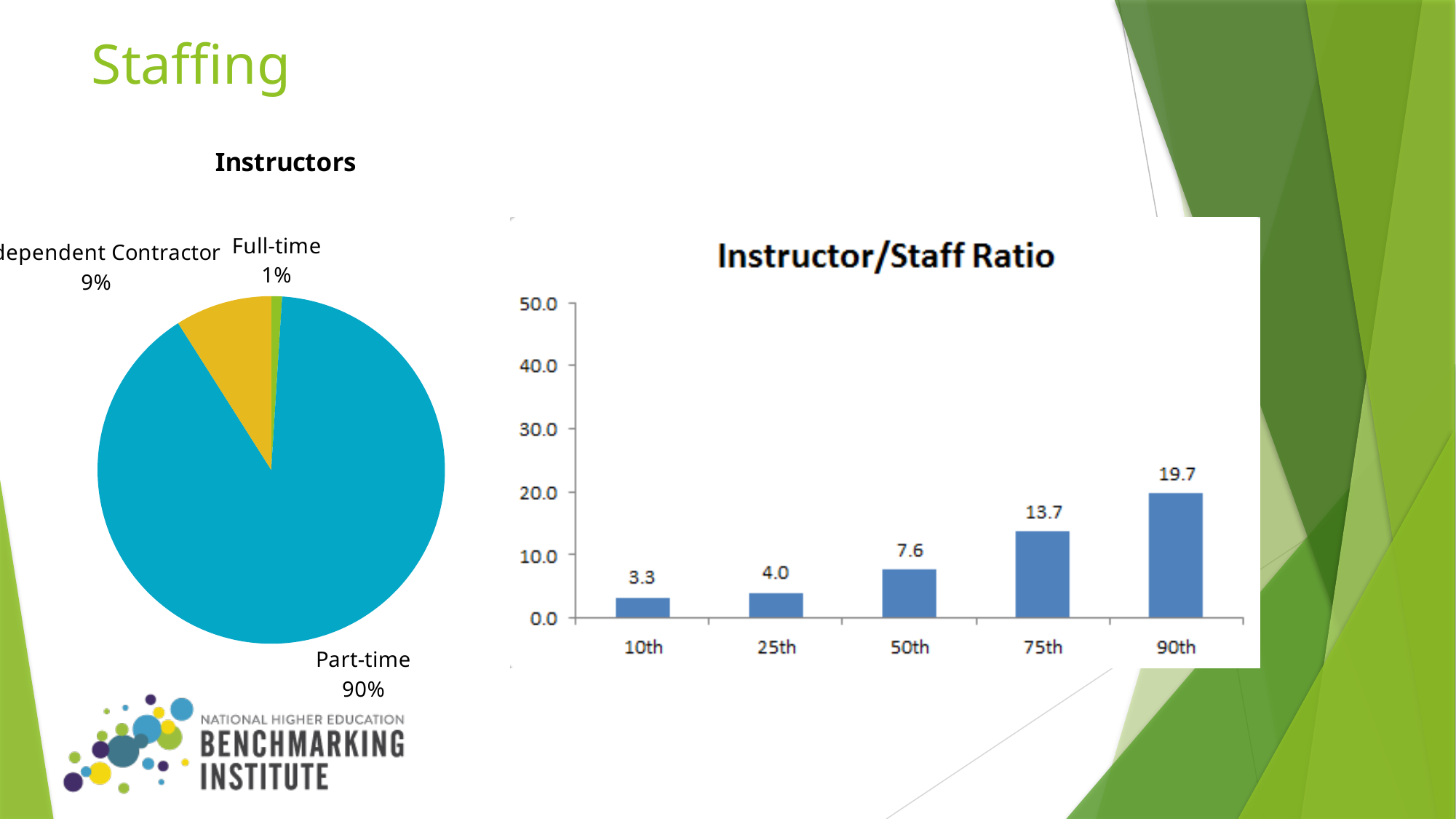
How many bars are in the Instructor/Staff Ratio chart? 5 In the Instructor/Staff Ratio chart, what is the value for the 90th percentile? 19.7 In the Instructor/Staff Ratio chart, what is the value for the 50th percentile? 7.6 In the Instructor/Staff Ratio chart, which percentile has the lowest value? 10th In the Instructor/Staff Ratio chart, is the value for the 90th percentile greater or less than 20.0? less In the Instructors pie chart, what share is Full-time? 1% In the Instructor/Staff Ratio chart, do the values rise or fall from the 10th to the 90th percentile? Rise In the Instructor/Staff Ratio chart, what is the difference between the 75th and 25th percentile values? 9.7 What kind of chart is the Instructors chart? Pie chart In the Instructors pie chart, what share is Part-time? 90% In the Instructors pie chart, which category has the largest slice? Part-time In the Instructors pie chart, which category has the smallest slice? Full-time